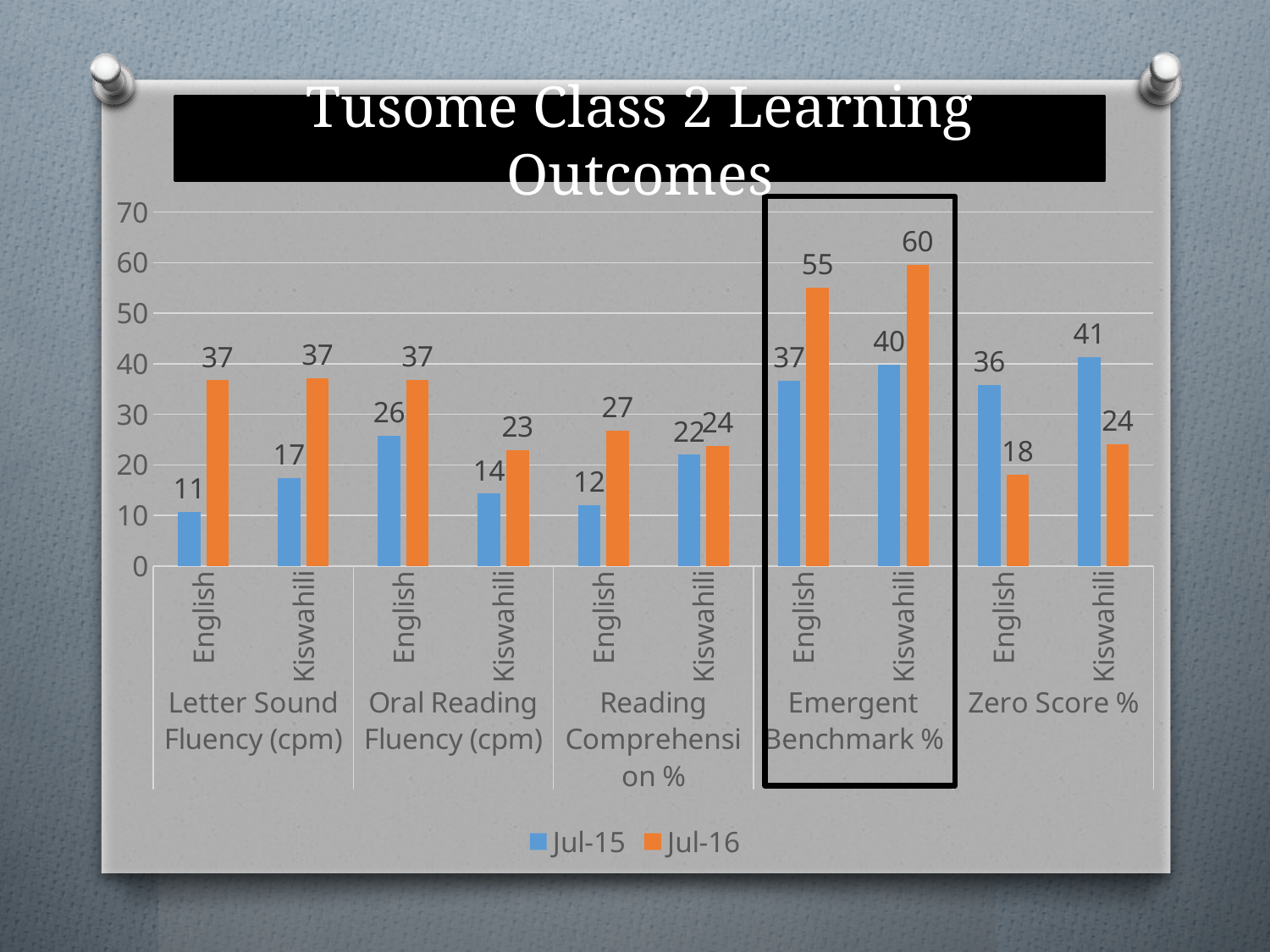
What is the Jul-15 value for Kiswahili Emergent Benchmark %? 40 How many category groups are shown along the x axis? 5 What is the Jul-16 value for English Zero Score %? 18 What is the Jul-15 value for English Reading Comprehension %? 12 Which bar has the highest value on the chart? Jul-16 Kiswahili Emergent Benchmark % What is the title of the chart? Tusome Class 2 Learning Outcomes What kind of chart is shown on the slide? Bar chart Which bar has the lowest value on the chart? Jul-15 English Letter Sound Fluency (cpm) What is the Jul-16 value for English Letter Sound Fluency (cpm)? 37 What is the difference between the Jul-16 and Jul-15 values for English Emergent Benchmark %? 18 Which is larger for Kiswahili Zero Score %: the Jul-15 value or the Jul-16 value? Jul-15 How many series does the legend list? 2